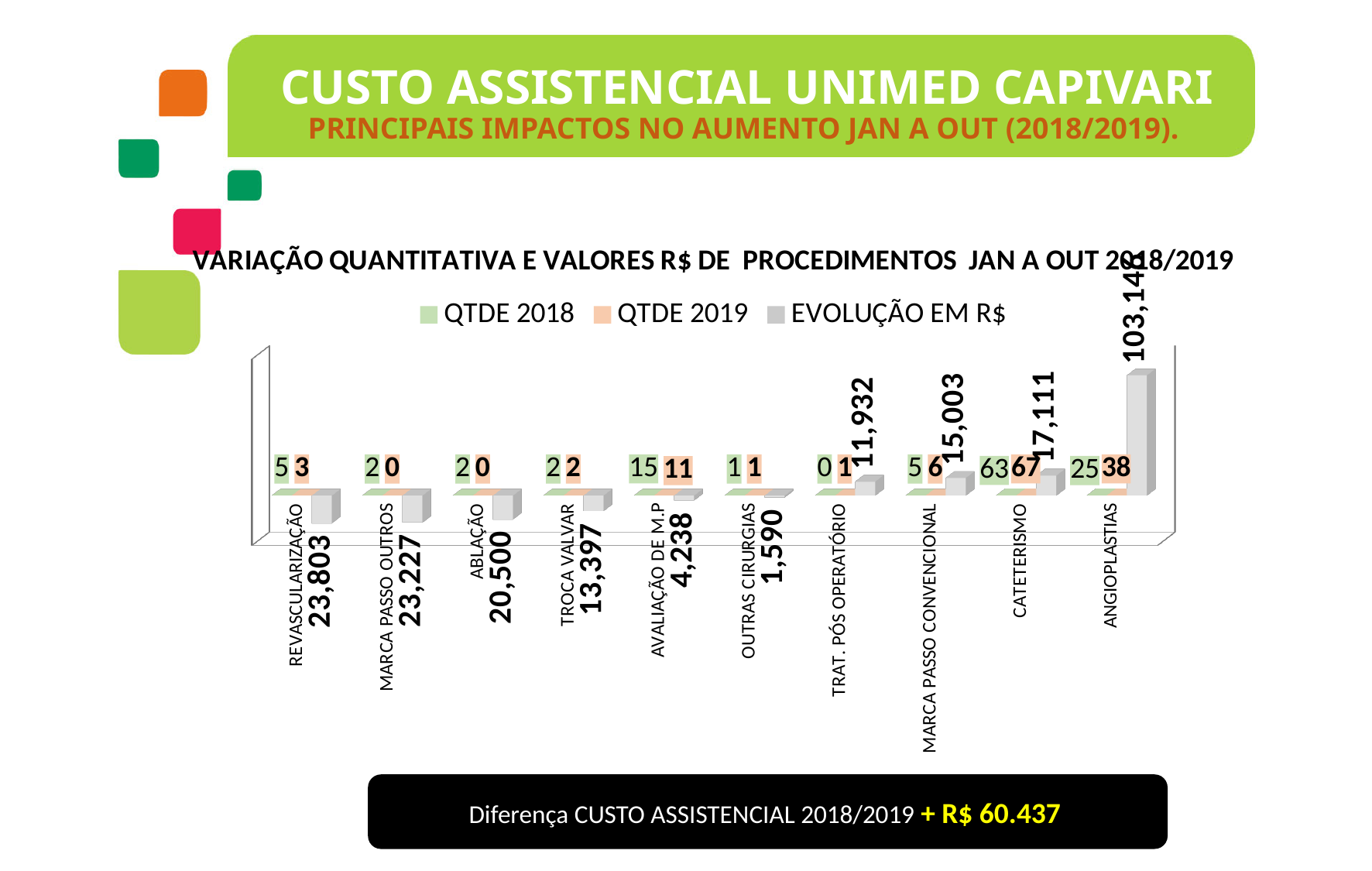
What kind of chart is shown on the slide? bar chart For CATETERISMO, what is the difference between QTDE 2019 and QTDE 2018? 4 Which category has the highest QTDE 2019 value? CATETERISMO What are the three legend entries of the chart? QTDE 2018, QTDE 2019, EVOLUÇÃO EM R$ What is the QTDE 2018 value for CATETERISMO? 63 Which category has the highest EVOLUÇÃO EM R$ value? ANGIOPLASTIAS What is the EVOLUÇÃO EM R$ value for ABLAÇÃO? 20,500 For AVALIAÇÃO DE M.P, which is larger: QTDE 2018 or QTDE 2019? QTDE 2018 How many procedure categories are shown on the x axis? 10 What is the EVOLUÇÃO EM R$ value for TRAT. PÓS OPERATÓRIO? 11,932 How many series does the legend list? 3 What is the QTDE 2019 value for ANGIOPLASTIAS? 38